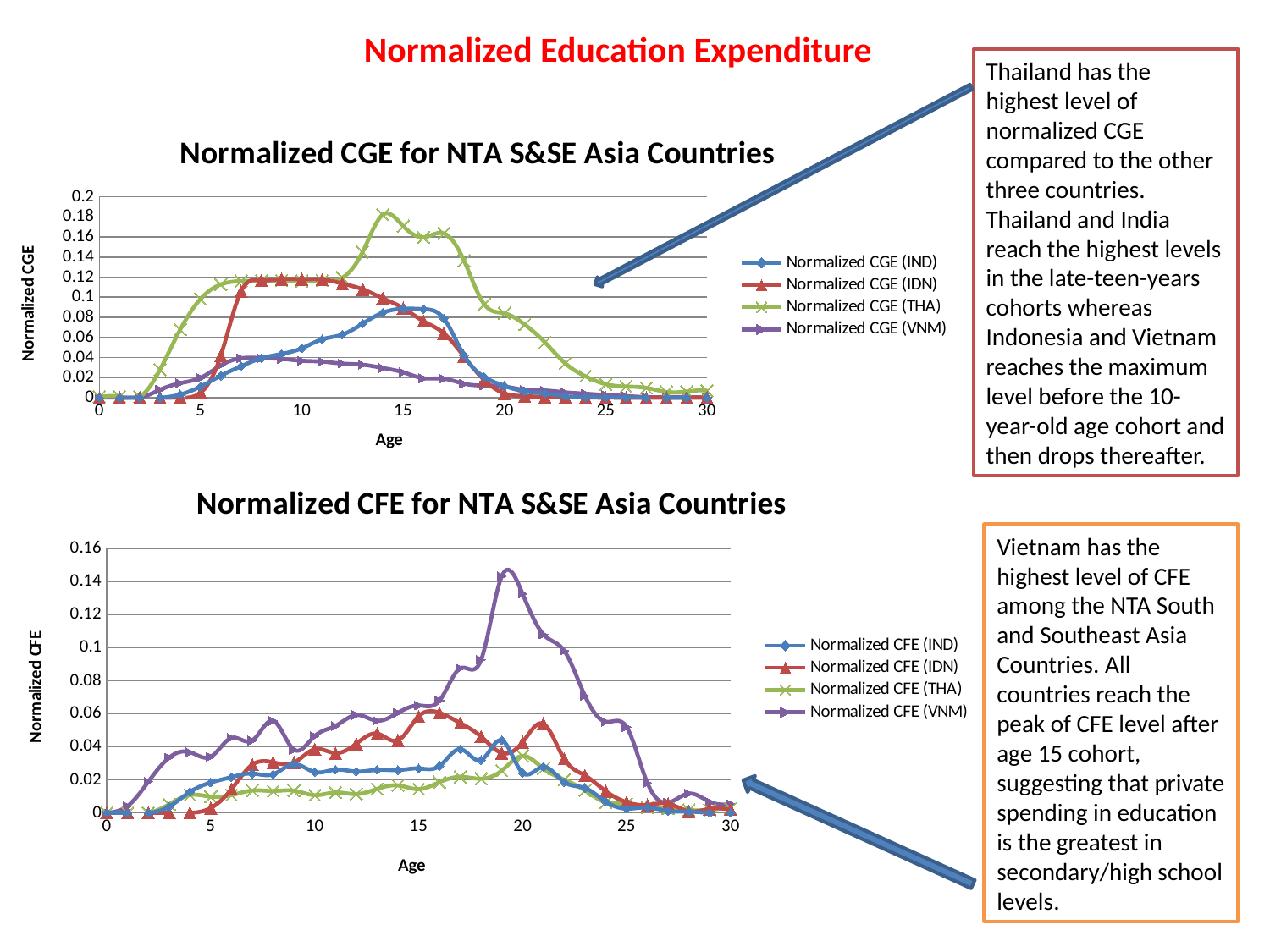
What kind of chart is the top chart, 'Normalized CGE for NTA S&SE Asia Countries'? Line chart In the top chart, 'Normalized CGE for NTA S&SE Asia Countries', is the value for Normalized CGE (THA) at age 14 greater or less than 0.16? greater In the bottom chart, 'Normalized CFE for NTA S&SE Asia Countries', which series reaches the highest peak value? Normalized CFE (VNM) How many series does the legend of the top chart, 'Normalized CGE for NTA S&SE Asia Countries', list? 4 In the top chart, 'Normalized CGE for NTA S&SE Asia Countries', is the value for Normalized CGE (VNM) at age 10 greater or less than 0.06? less In the bottom chart, 'Normalized CFE for NTA S&SE Asia Countries', is the value for Normalized CFE (VNM) at age 19 greater or less than 0.12? greater In the top chart, 'Normalized CGE for NTA S&SE Asia Countries', which series reaches the highest peak value? Normalized CGE (THA) What is the label of the x axis on the bottom chart, 'Normalized CFE for NTA S&SE Asia Countries'? Age In the top chart, 'Normalized CGE for NTA S&SE Asia Countries', at age 10, which is larger: Normalized CGE (IDN) or Normalized CGE (IND)? Normalized CGE (IDN) In the bottom chart, 'Normalized CFE for NTA S&SE Asia Countries', at age 19, which is larger: Normalized CFE (VNM) or Normalized CFE (IDN)? Normalized CFE (VNM) How many series does the legend of the bottom chart, 'Normalized CFE for NTA S&SE Asia Countries', list? 4